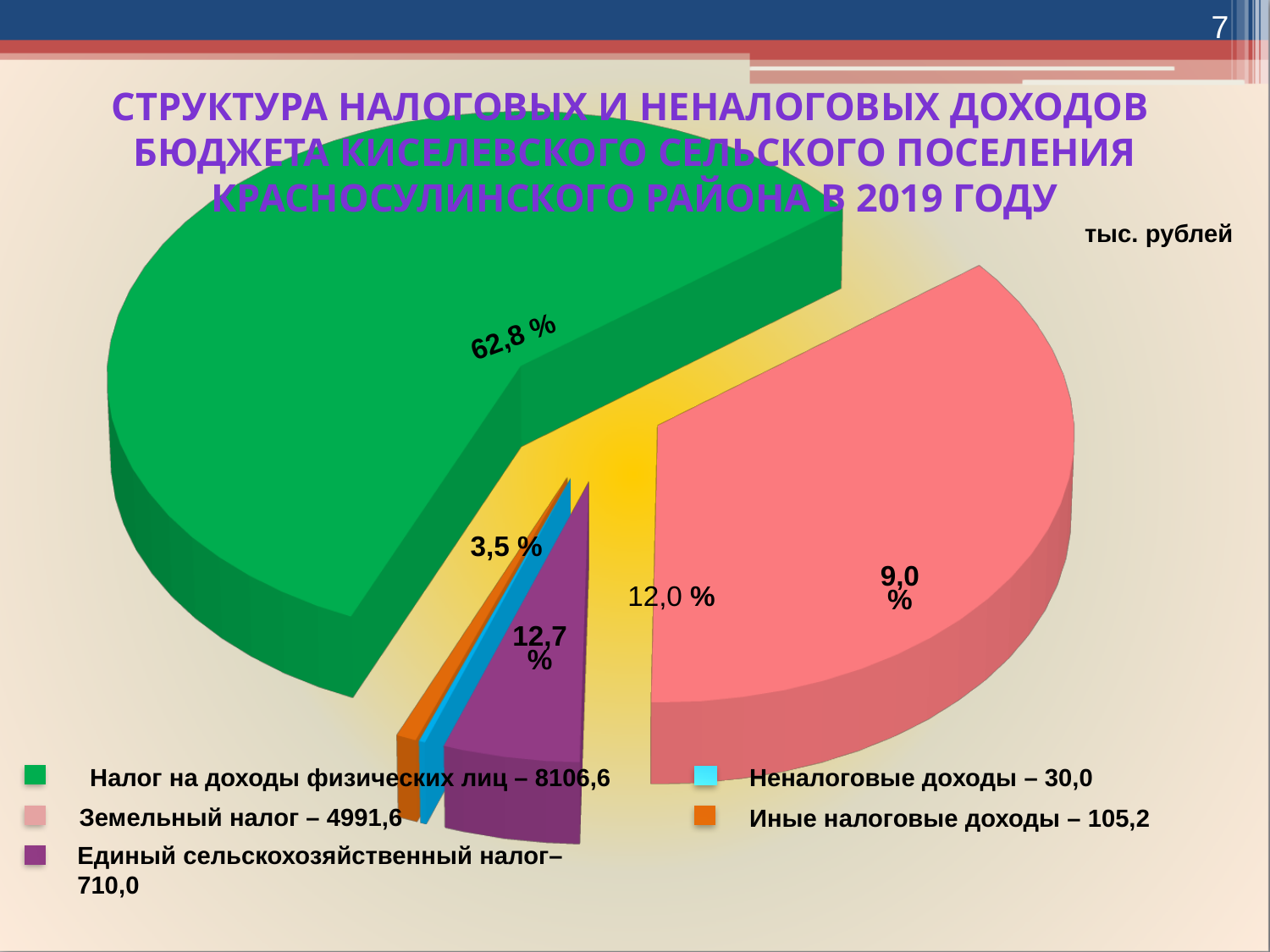
Which category has the smallest value in the legend? Неналоговые доходы What value is shown in the legend for Налог на доходы физических лиц? 8106,6 What unit is indicated for the values on the slide? тыс. рублей Which category has the largest value in the legend? Налог на доходы физических лиц Which is larger: Земельный налог or Единый сельскохозяйственный налог? Земельный налог What value is shown in the legend for Единый сельскохозяйственный налог? 710,0 How many categories does the legend list? 5 What kind of chart is shown on the slide? Pie chart What value is shown in the legend for Иные налоговые доходы? 105,2 What value is shown in the legend for Неналоговые доходы? 30,0 What is the difference between the values for Налог на доходы физических лиц and Земельный налог? 3115,0 What value is shown in the legend for Земельный налог? 4991,6